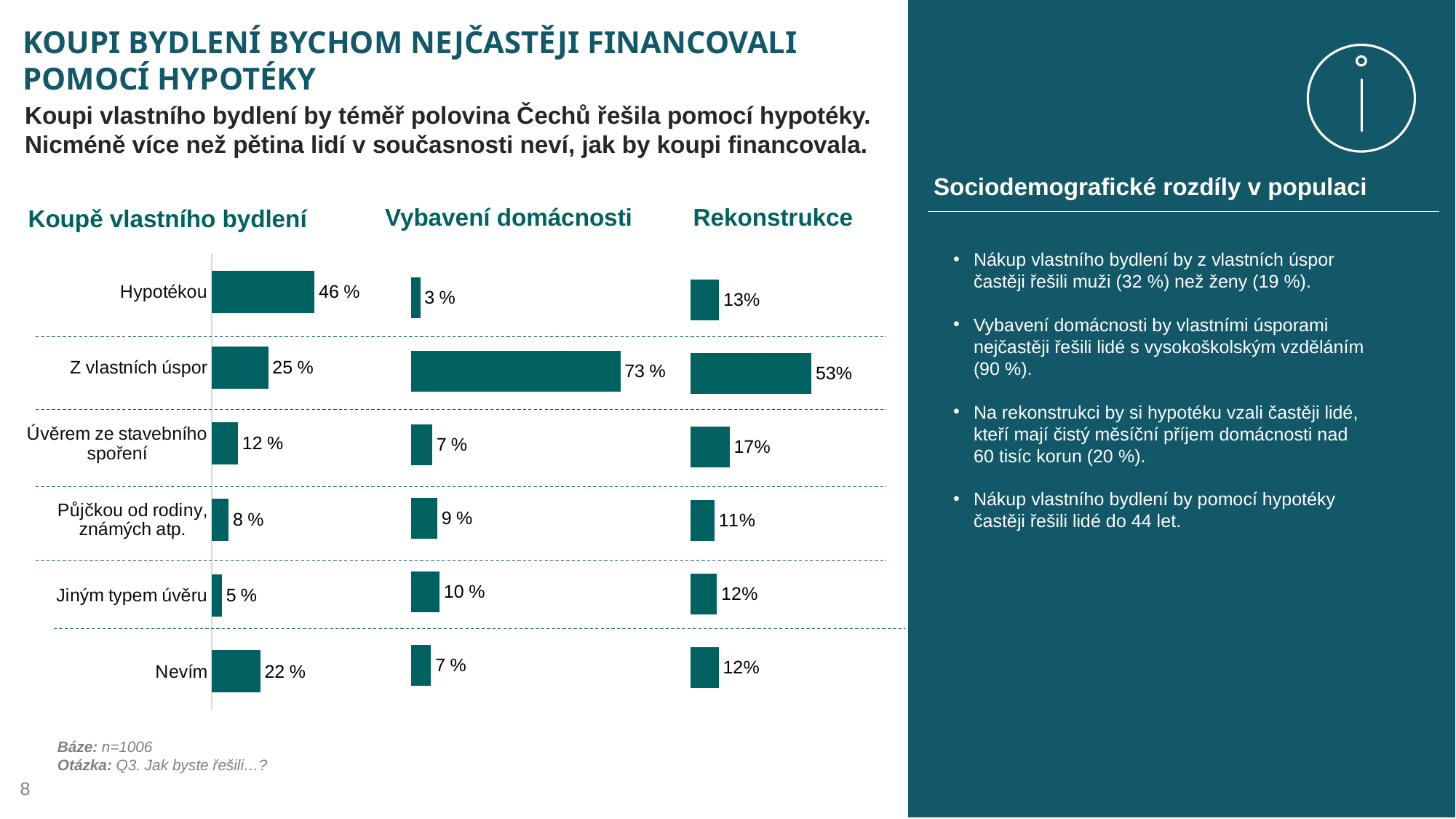
In the 'Koupě vlastního bydlení' chart, what is the value for 'Nevím'? 22 % In the 'Rekonstrukce' chart, what is the difference between 'Z vlastních úspor' and 'Hypotékou'? 40% How many categories are shown in the 'Vybavení domácnosti' chart? 6 In the 'Rekonstrukce' chart, which category has the highest value? Z vlastních úspor In the 'Koupě vlastního bydlení' chart, which category has the highest value? Hypotékou In the 'Koupě vlastního bydlení' chart, which is larger: 'Nevím' or 'Úvěrem ze stavebního spoření'? Nevím In the 'Koupě vlastního bydlení' chart, what is the difference between 'Hypotékou' and 'Z vlastních úspor'? 21 % In the 'Koupě vlastního bydlení' chart, what is the value for 'Hypotékou'? 46 % In the 'Vybavení domácnosti' chart, which category has the lowest value? Hypotékou In the 'Rekonstrukce' chart, what is the value for 'Úvěrem ze stavebního spoření'? 17% What type of chart is the 'Rekonstrukce' chart? Bar chart In the 'Vybavení domácnosti' chart, what is the value for 'Z vlastních úspor'? 73 %